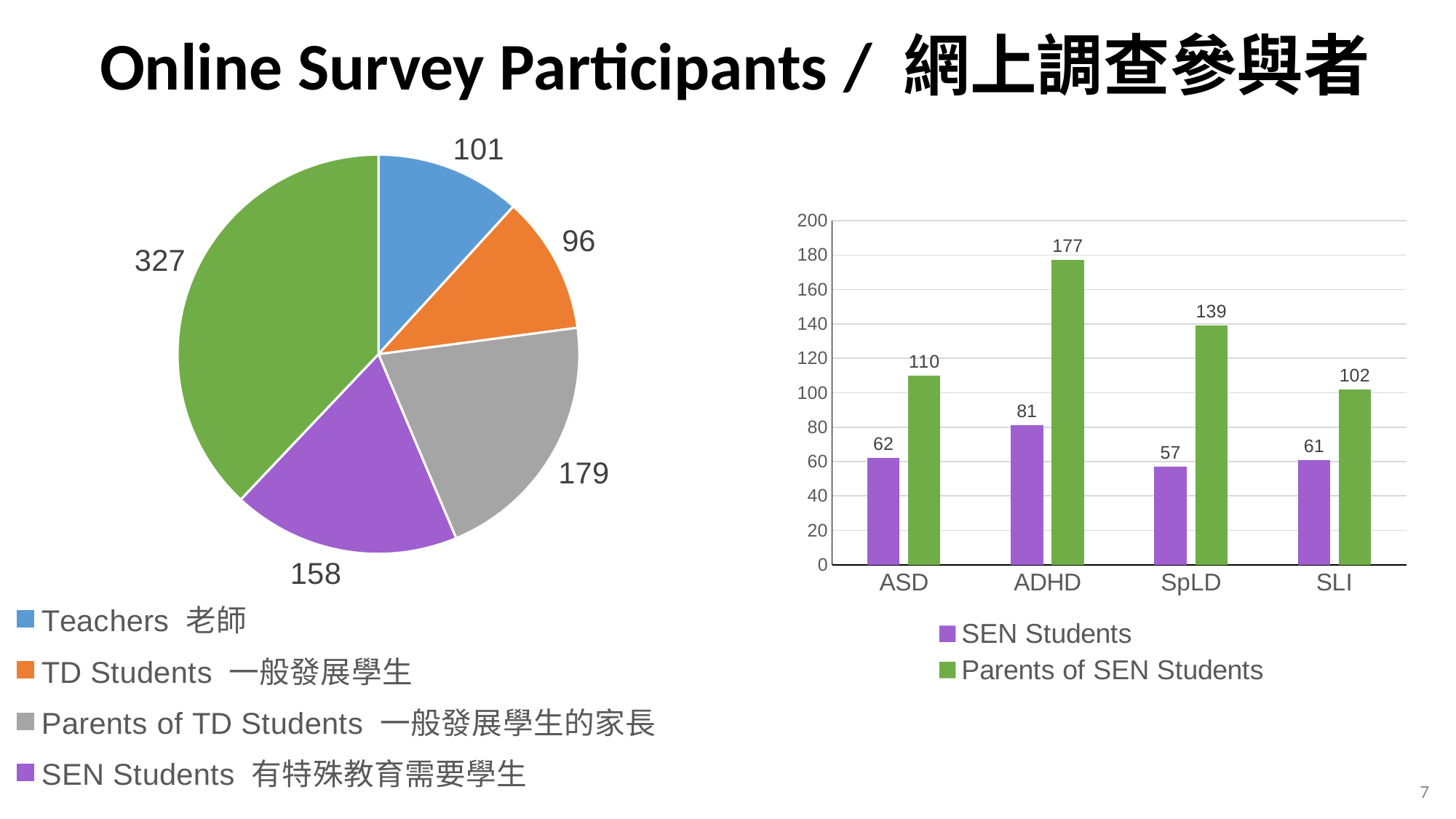
On the bar chart on the right, which category has the lowest value for SEN Students? SpLD What kind of chart is on the left of the slide? Pie chart On the bar chart on the right, what is the value for SEN Students for SpLD? 57 On the pie chart on the left, what is the value for Parents of TD Students? 179 On the pie chart on the left, how many slices are there? 5 On the pie chart on the left, which is larger, Teachers or TD Students? Teachers On the bar chart on the right, which category has the highest value for Parents of SEN Students? ADHD On the bar chart on the right, how many series does the legend list? 2 On the bar chart on the right, what is the difference between Parents of SEN Students and SEN Students for SLI? 41 On the bar chart on the right, what is the value for Parents of SEN Students for ADHD? 177 On the pie chart on the left, what is the value for Teachers? 101 On the pie chart on the left, what is the difference between SEN Students and TD Students? 62